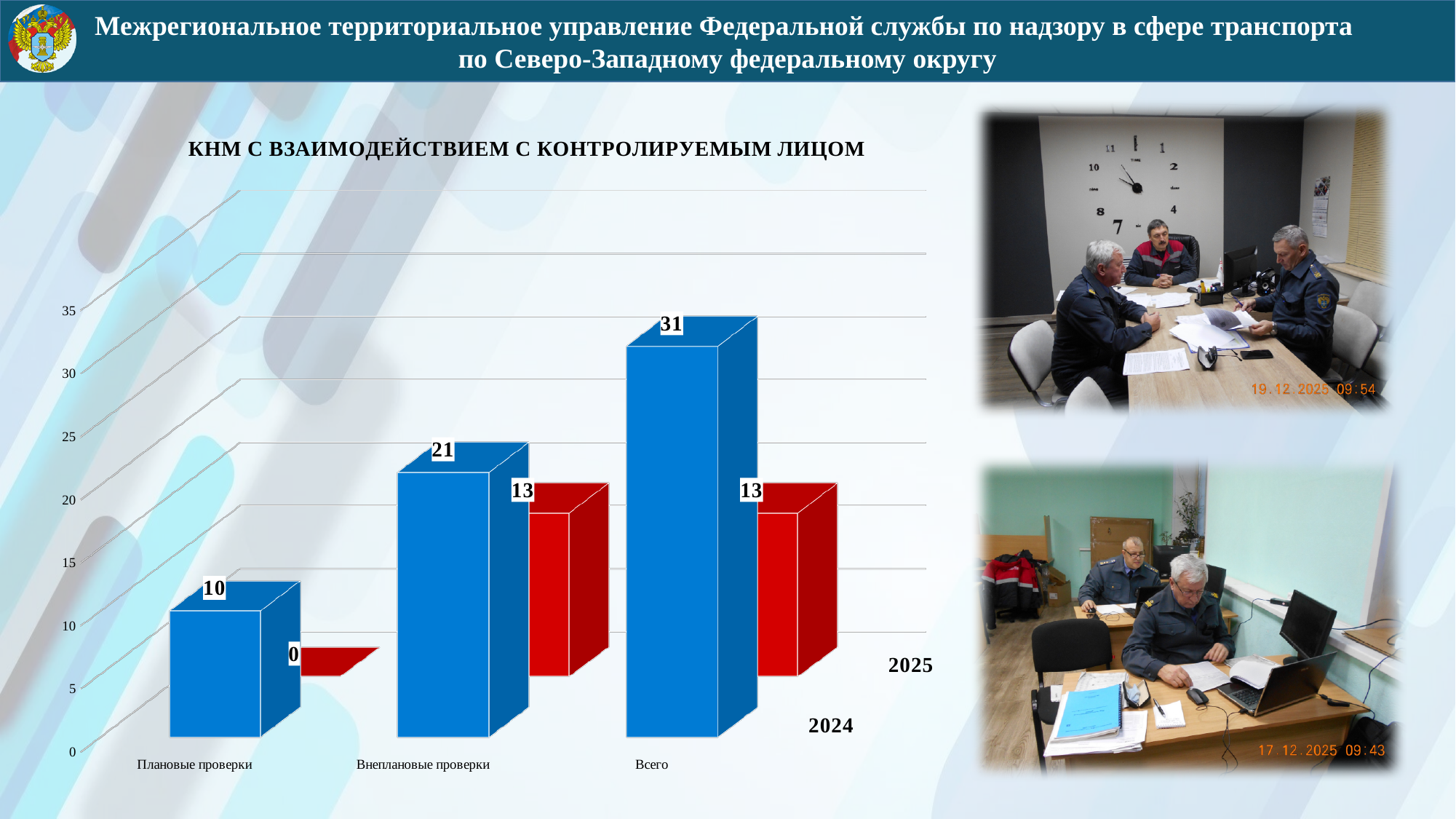
What is the title of the chart? КНМ С ВЗАИМОДЕЙСТВИЕМ С КОНТРОЛИРУЕМЫМ ЛИЦОМ What is the value for Всего in 2024? 31 What is the difference between the 2024 and 2025 values for Внеплановые проверки? 8 What is the difference between the 2024 and 2025 values for Всего? 18 What is the value for Плановые проверки in 2025? 0 What is the value for Плановые проверки in 2024? 10 How many categories are shown on the x axis? 3 Which is larger for Внеплановые проверки: the 2024 value or the 2025 value? 2024 What is the value for Внеплановые проверки in 2025? 13 Which category has the lowest value in 2025? Плановые проверки Which category has the highest value in 2024? Всего What kind of chart is shown on the slide? Bar chart